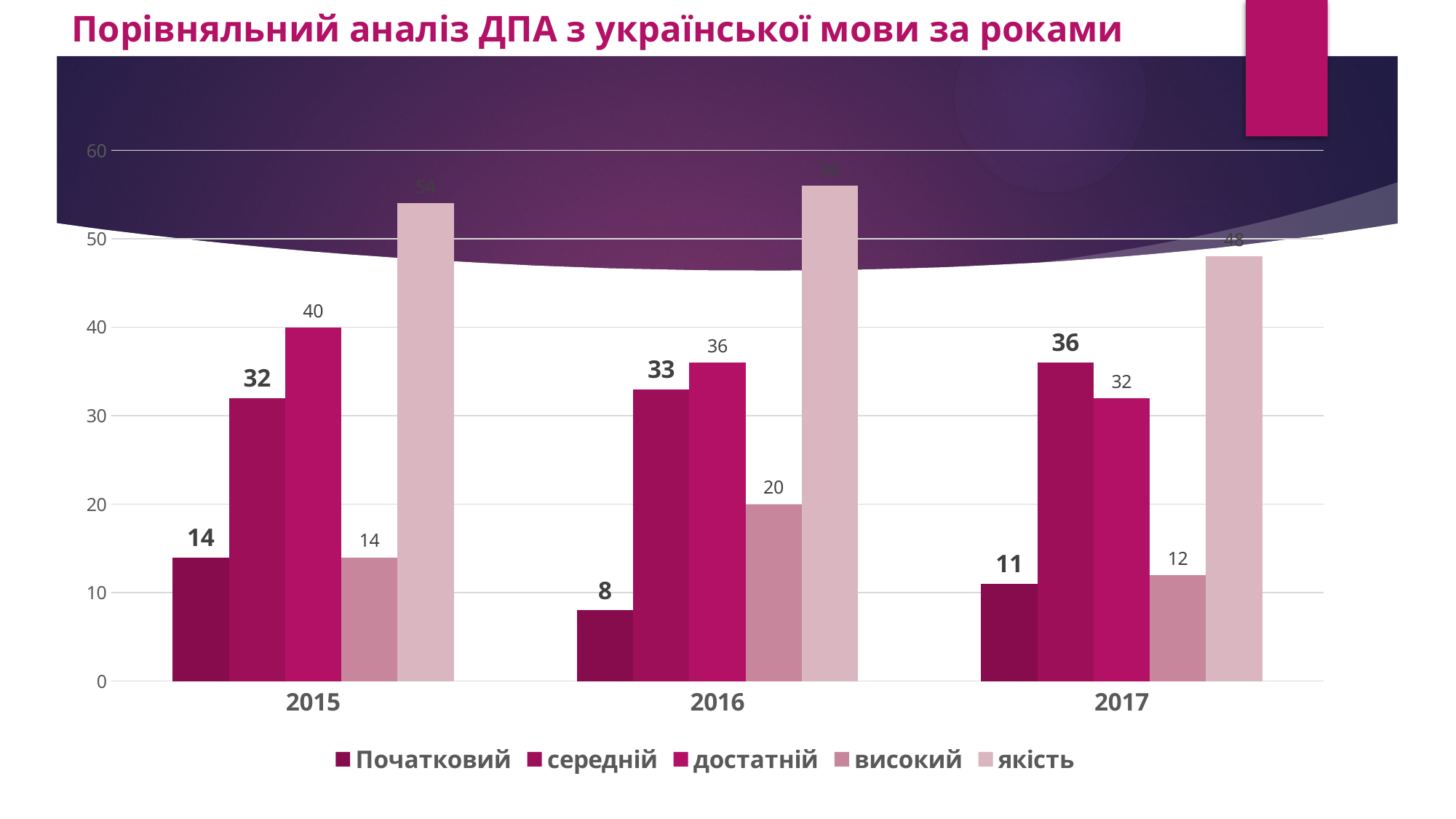
Is the value for якість in 2016 greater or less than 50? greater What kind of chart is shown on the slide? bar chart What is the value for високий in 2017? 12 Does the value for середній rise or fall from 2015 to 2017? rise How many years are shown on the x axis? 3 In which year is the value for Початковий the highest? 2015 Which year has the larger value for достатній, 2015 or 2016? 2015 What is the value for Початковий in 2015? 14 What is the difference between the середній values for 2017 and 2015? 4 What is the value for достатній in 2016? 36 How many series does the legend list? 5 In which year is the value for Початковий the lowest? 2016